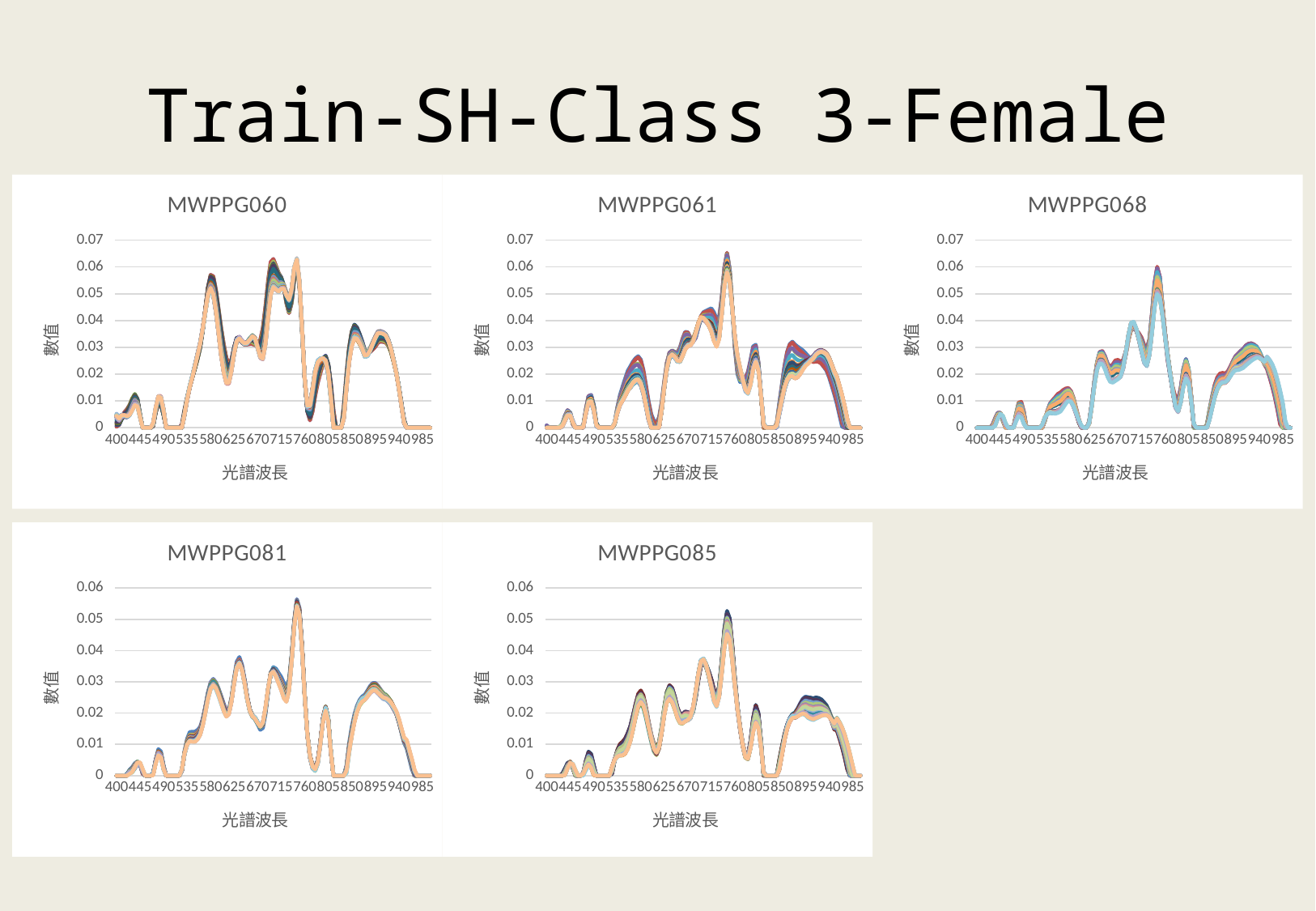
In the MWPPG085 chart, is the highest peak near 760 on the x axis greater or less than 0.04? greater How many charts are shown on the slide? 5 In the MWPPG061 chart, are the values at 400 on the x axis greater or less than 0.01? less What is the highest value shown on the y axis of the MWPPG061 chart? 0.07 What kind of chart is MWPPG060? line chart In the MWPPG060 chart, is the highest peak near 760 on the x axis greater or less than 0.05? greater What is the x-axis label of the MWPPG085 chart? 光譜波長